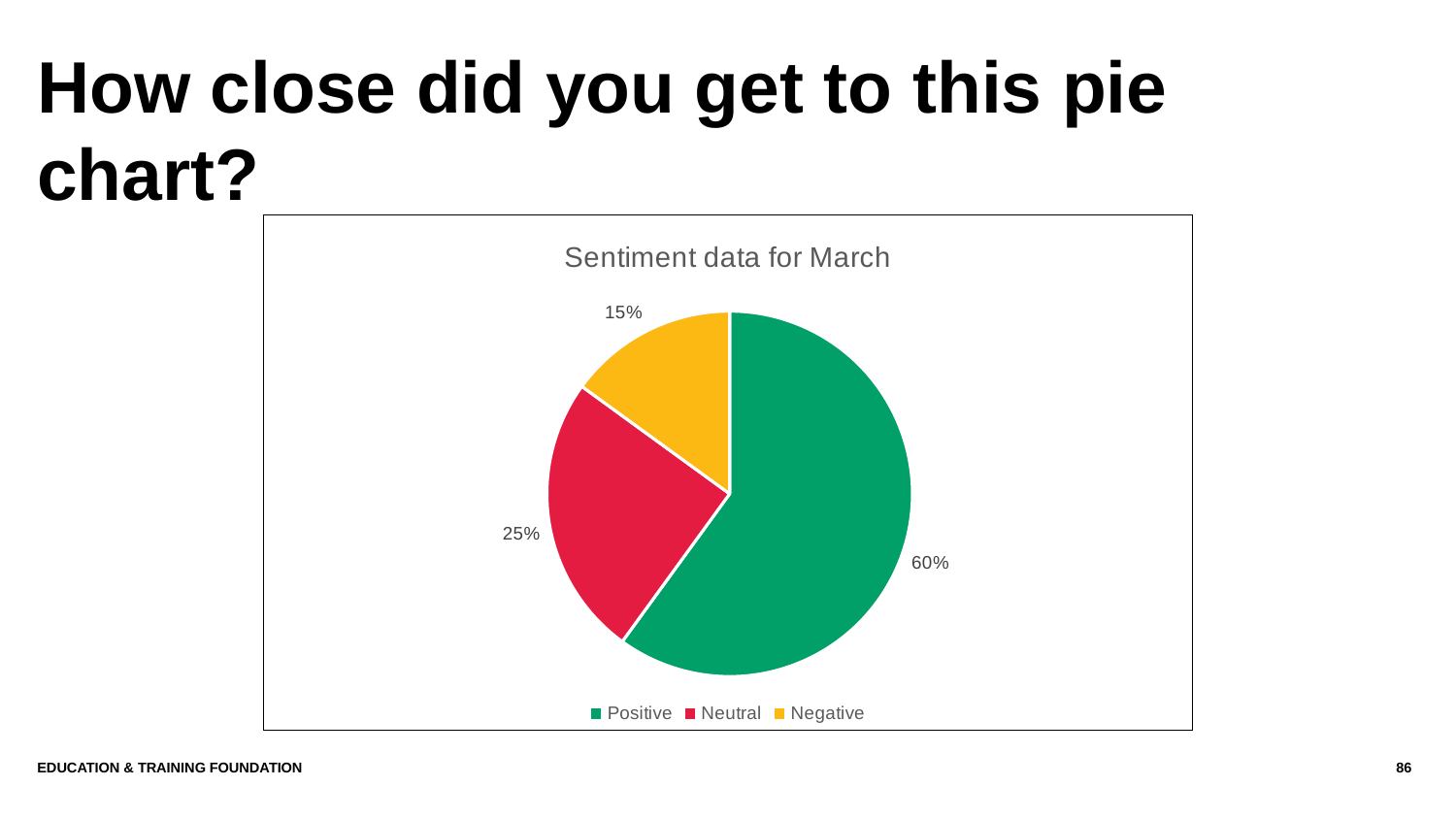
What percentage of the pie is Positive? 60% Which is larger, the Neutral share or the Negative share? Neutral Which category has the smallest share of the pie? Negative What percentage of the pie is Negative? 15% What is the difference between the Neutral and Negative shares? 10% What is the title of the chart? Sentiment data for March Which category has the largest share of the pie? Positive What kind of chart is shown on the slide? pie chart How many categories does the pie chart have? 3 What percentage of the pie is Neutral? 25% What is the difference between the Positive and Neutral shares? 35% Which colour represents Negative in the legend? yellow